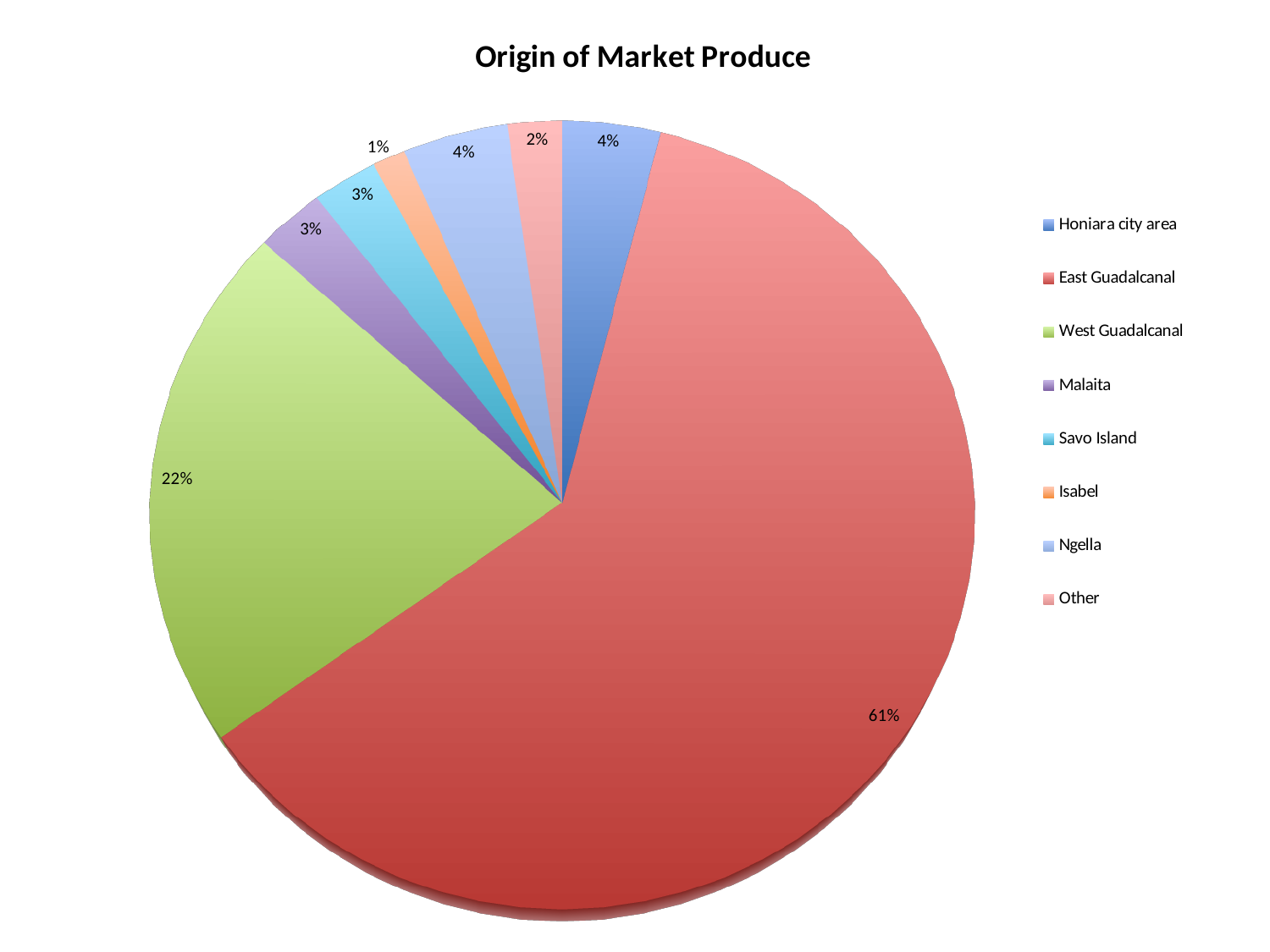
How many categories does the legend list? 8 What percentage is shown for the Other slice? 2% Which has a larger share, Ngella or Other? Ngella What percentage is shown for the Honiara city area slice? 4% What share of market produce comes from East Guadalcanal? 61% What share of market produce comes from West Guadalcanal? 22% What is the difference in percentage points between East Guadalcanal and West Guadalcanal? 39 What is the title of the chart? Origin of Market Produce What type of chart is shown on the slide? pie chart Which origin has the smallest share of market produce? Isabel Which origin has the largest share of market produce? East Guadalcanal What percentage is shown for the Isabel slice? 1%